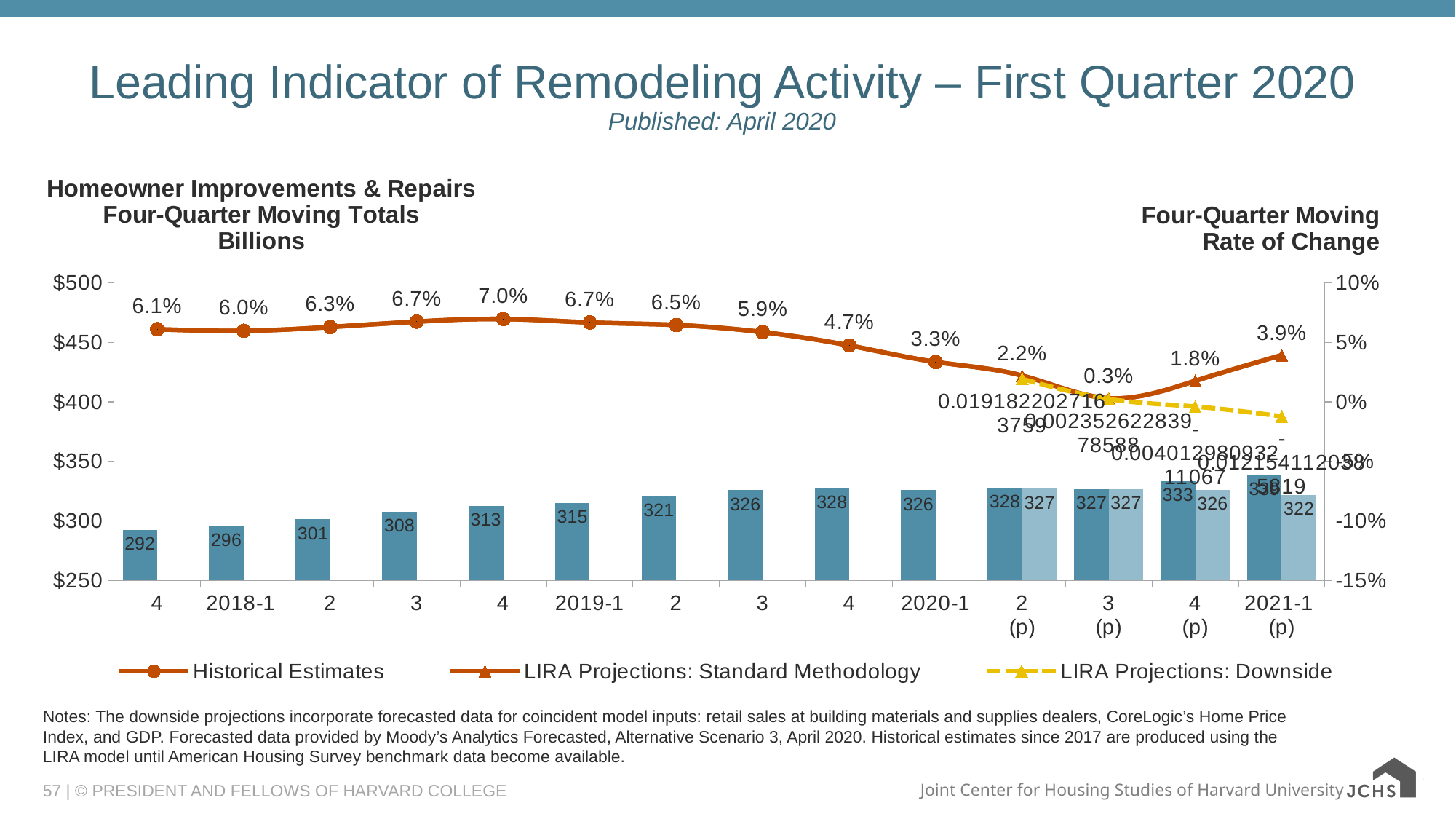
How many quarters are shown along the x axis? 14 Does the Historical Estimates rate of change rise or fall from 2019-1 to 2020-1? Fall Is the four-quarter moving total for 2018-1 greater or less than $300? less What is the highest Historical Estimates rate of change shown on the chart? 7.0% What is the difference between the four-quarter moving totals for 2019-1 and 2018-1? 19 What is the Historical Estimates rate of change for 2018-1? 6.0% How many series does the legend list? 3 What is the lowest four-quarter moving total shown by the bars? 292 What is the LIRA Projections: Standard Methodology rate of change for 2021-1 (p)? 3.9% What kind of chart is this? Combination bar and line chart Which has the larger four-quarter moving total: the third quarter of 2019 or the fourth quarter of 2019? Fourth quarter of 2019 What is the four-quarter moving total (in billions) shown for 2019-1? 315